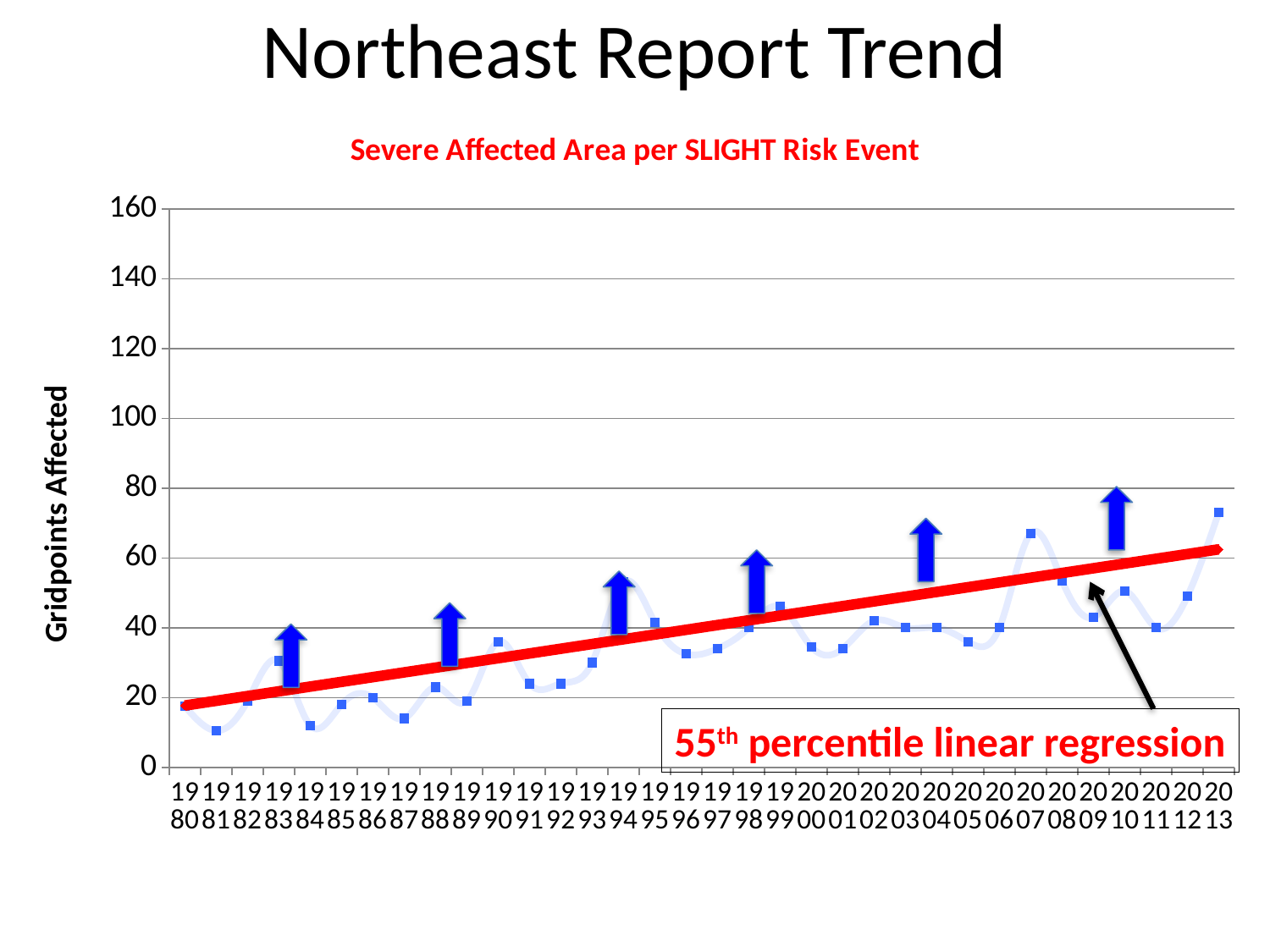
What is the title of the chart? Severe Affected Area per SLIGHT Risk Event Which year has the highest value? 2013 Is the value for 1994 greater or less than 40? greater What is the label of the vertical axis? Gridpoints Affected Which year has the larger value, 1994 or 1996? 1994 Is the value for 2007 greater or less than 60? greater Is the value for 2013 greater or less than 60? greater Do the values generally rise or fall from 1980 to 2013? rise Which year has the larger value, 2007 or 1980? 2007 How many years are plotted along the x axis? 34 What kind of chart is shown on the slide? line chart